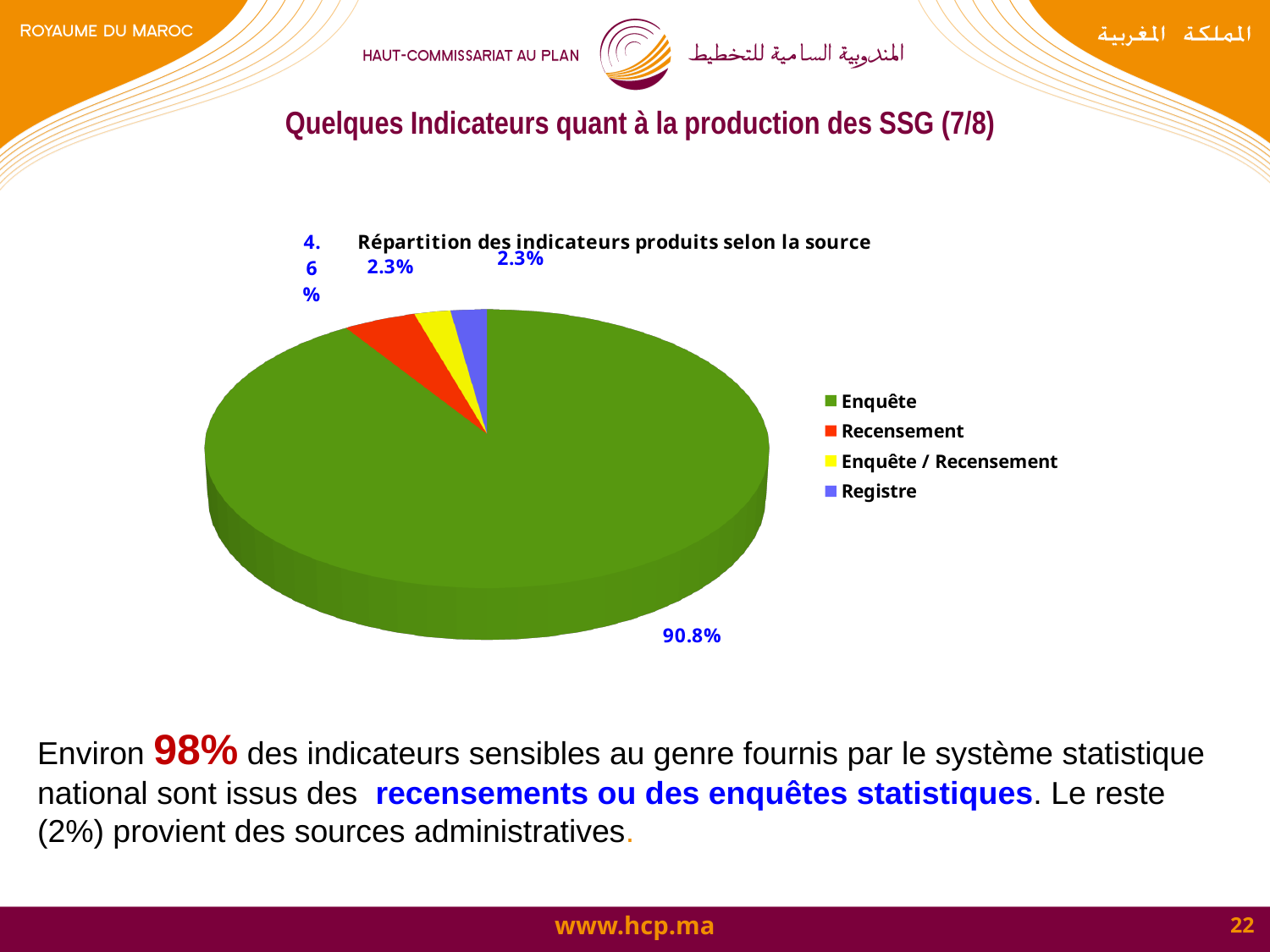
What share of the pie does Enquête represent? 90.8% How many entries does the legend list? 4 How many slices does the pie chart have? 4 What share of the pie does Enquête / Recensement represent? 2.3% Which source accounts for the largest slice of the pie? Enquête What type of chart is shown on the slide? Pie chart What share of the pie does Registre represent? 2.3% What share of the pie does Recensement represent? 4.6% Which is larger, the share for Enquête or the share for Recensement? Enquête What colour is the Enquête slice in the pie chart? Green What is the title of the chart? Répartition des indicateurs produits selon la source What is the difference in percentage points between the Enquête share and the Recensement share? 86.2 percentage points